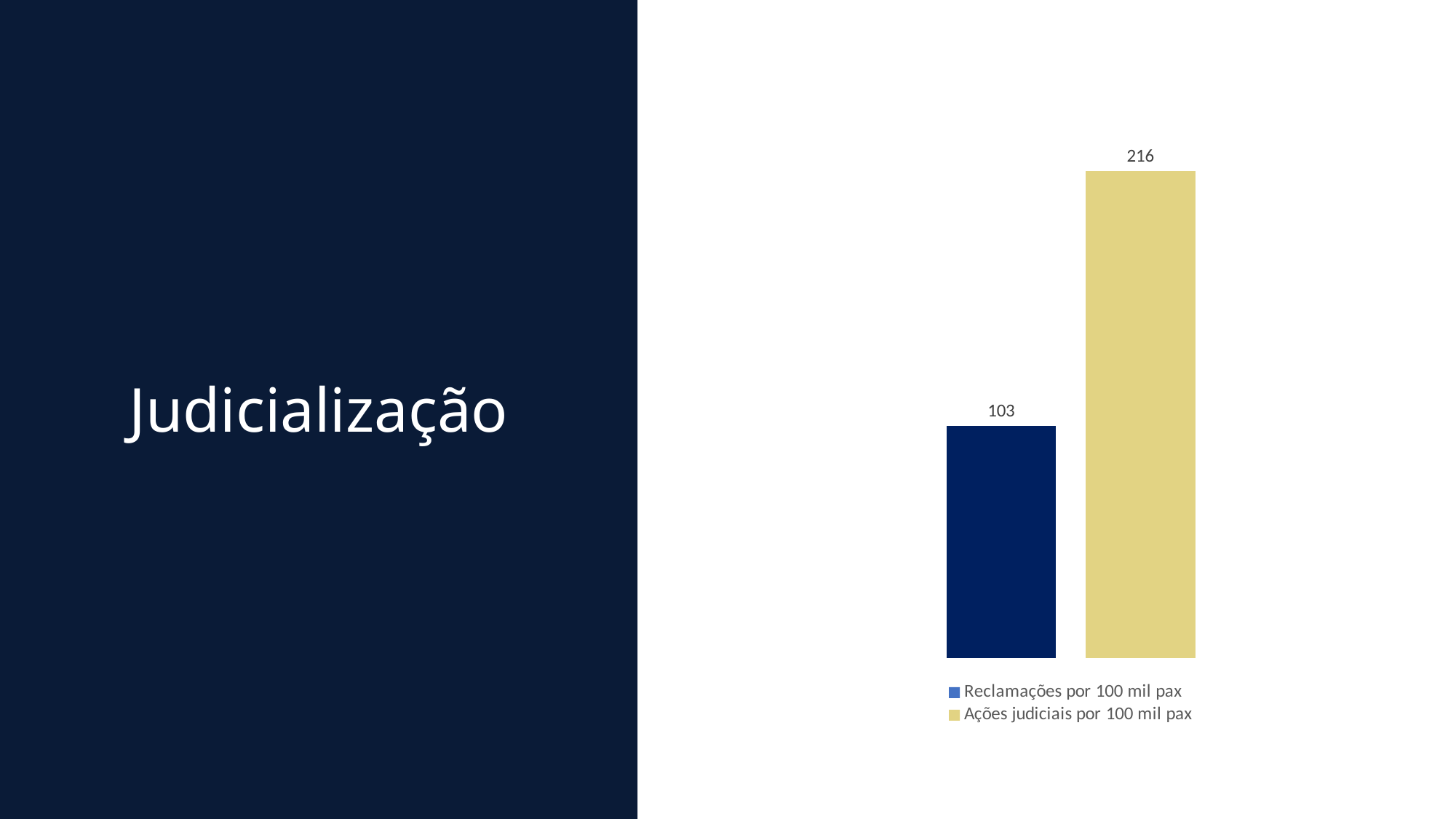
What kind of chart is shown on the slide? bar chart Which series has the higher value? Ações judiciais por 100 mil pax How many bars are plotted on the chart? 2 How many series does the legend list? 2 What is the difference between Ações judiciais por 100 mil pax and Reclamações por 100 mil pax? 113 What is the value for Ações judiciais por 100 mil pax? 216 What is the title of the slide? Judicialização What colour is the bar for Ações judiciais por 100 mil pax? yellow Which series has the lower value? Reclamações por 100 mil pax What is the value for Reclamações por 100 mil pax? 103 Is the value for Ações judiciais por 100 mil pax larger or smaller than the value for Reclamações por 100 mil pax? larger